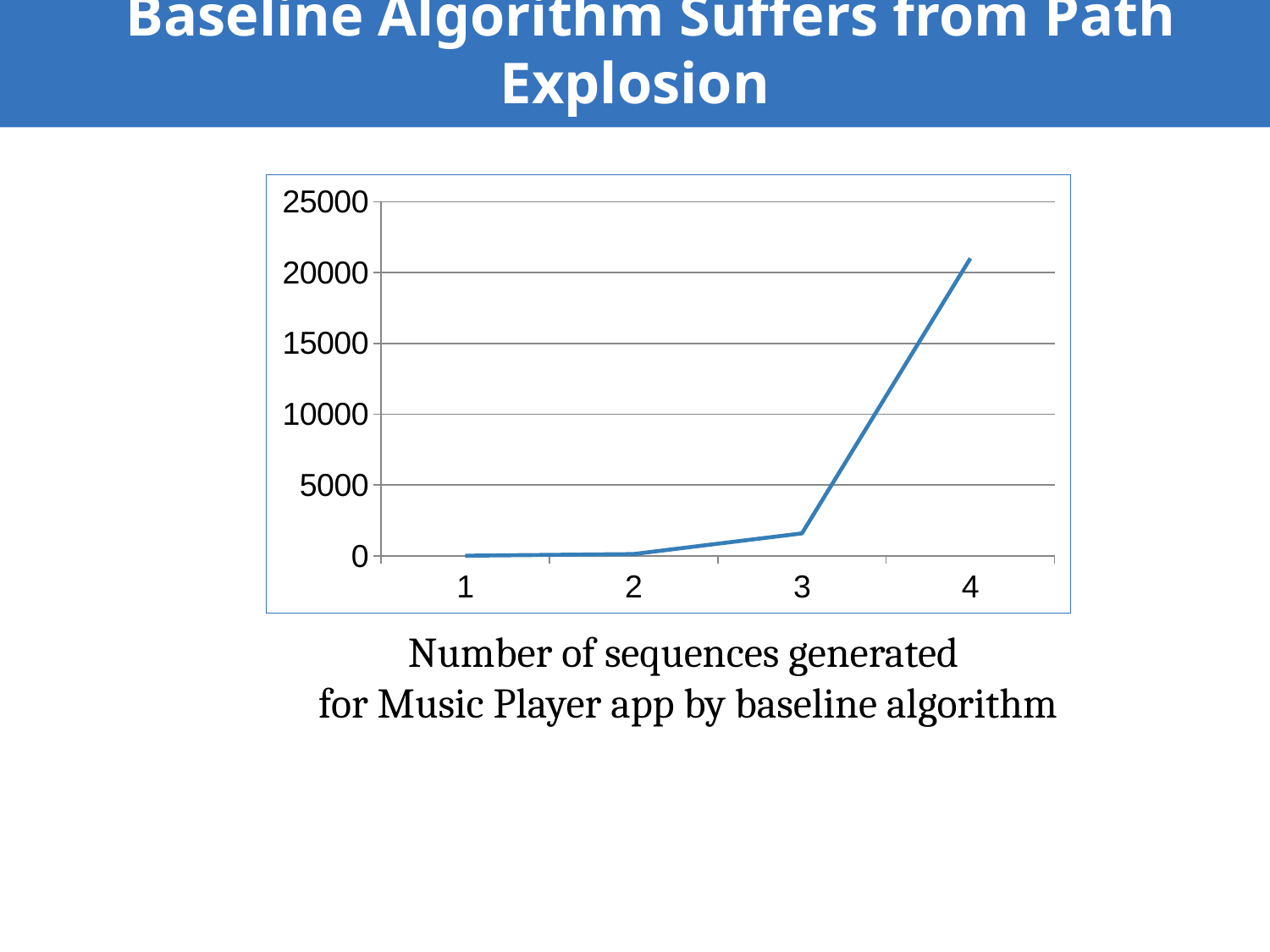
Is the value at x = 3 greater or less than 5000? less Do the values rise or fall as x increases from 1 to 4? rise Which has the larger value, x = 2 or x = 3? 3 According to the caption, which app does the chart show the number of sequences generated for? Music Player app How many points are plotted on the line chart? 4 Is the value at x = 4 greater or less than 10000? greater Is the value at x = 1 greater or less than 5000? less At which x-axis value is the number of sequences highest? 4 What is the highest value shown on the y axis? 25000 What kind of chart is shown on the slide? line chart Which has the larger value, x = 3 or x = 4? 4